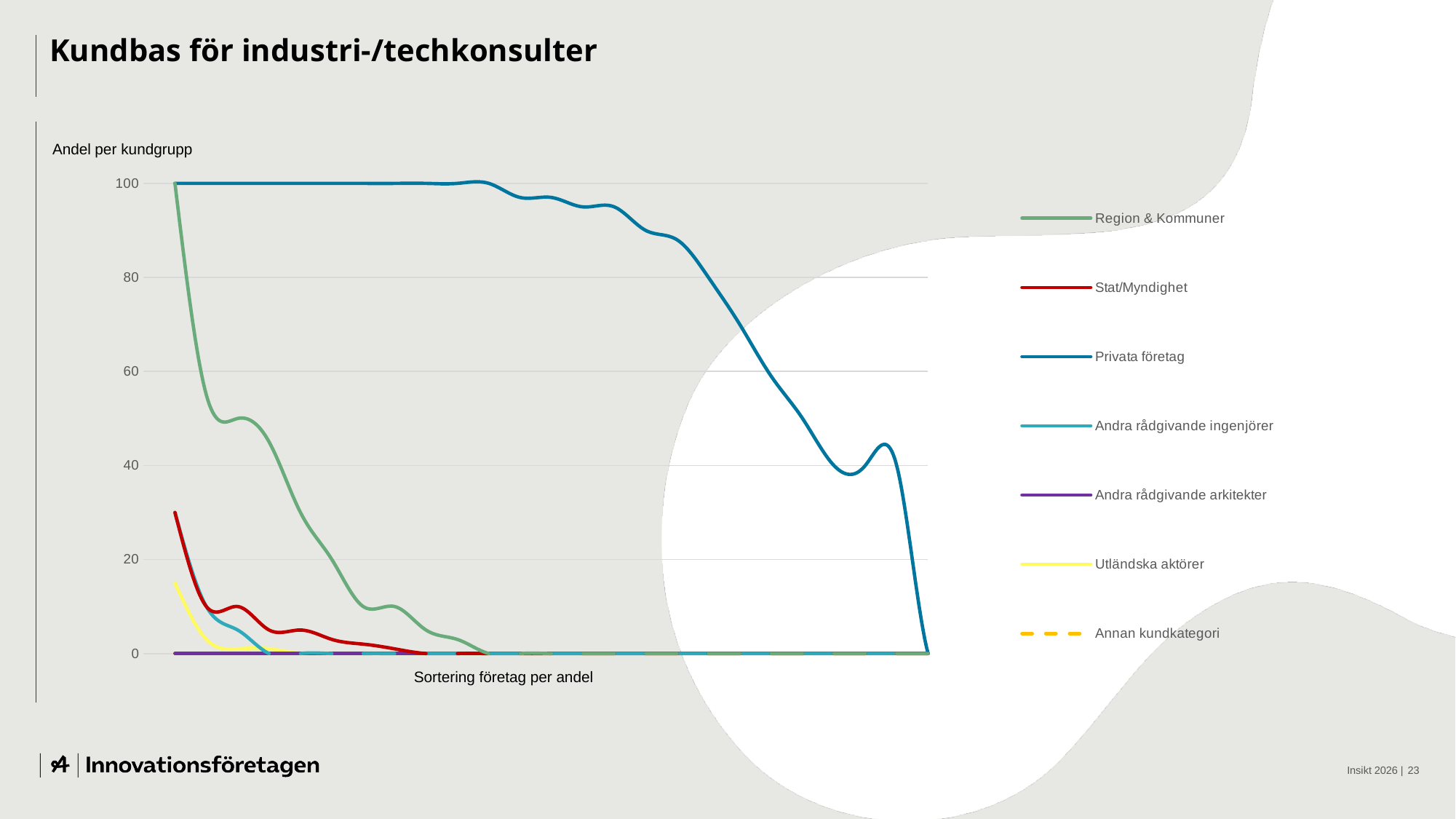
What value does the Privata företag line start at on the left edge of the chart? 100 Does the Region & Kommuner line rise or fall from left to right? fall What value does the Region & Kommuner line start at on the left edge of the chart? 100 How many series does the legend list? 7 What is the label on the x axis? Sortering företag per andel Is the starting value of the Stat/Myndighet line greater or less than 40? less At the left edge of the chart, which is higher: Region & Kommuner or Stat/Myndighet? Region & Kommuner What is the title of the slide's chart? Kundbas för industri-/techkonsulter Which series stays at 100 for the longest stretch along the x axis? Privata företag Is the starting value of the Utländska aktörer line greater or less than 20? less What kind of chart is shown on the slide? line chart What value do all the lines reach at the right end of the chart? 0